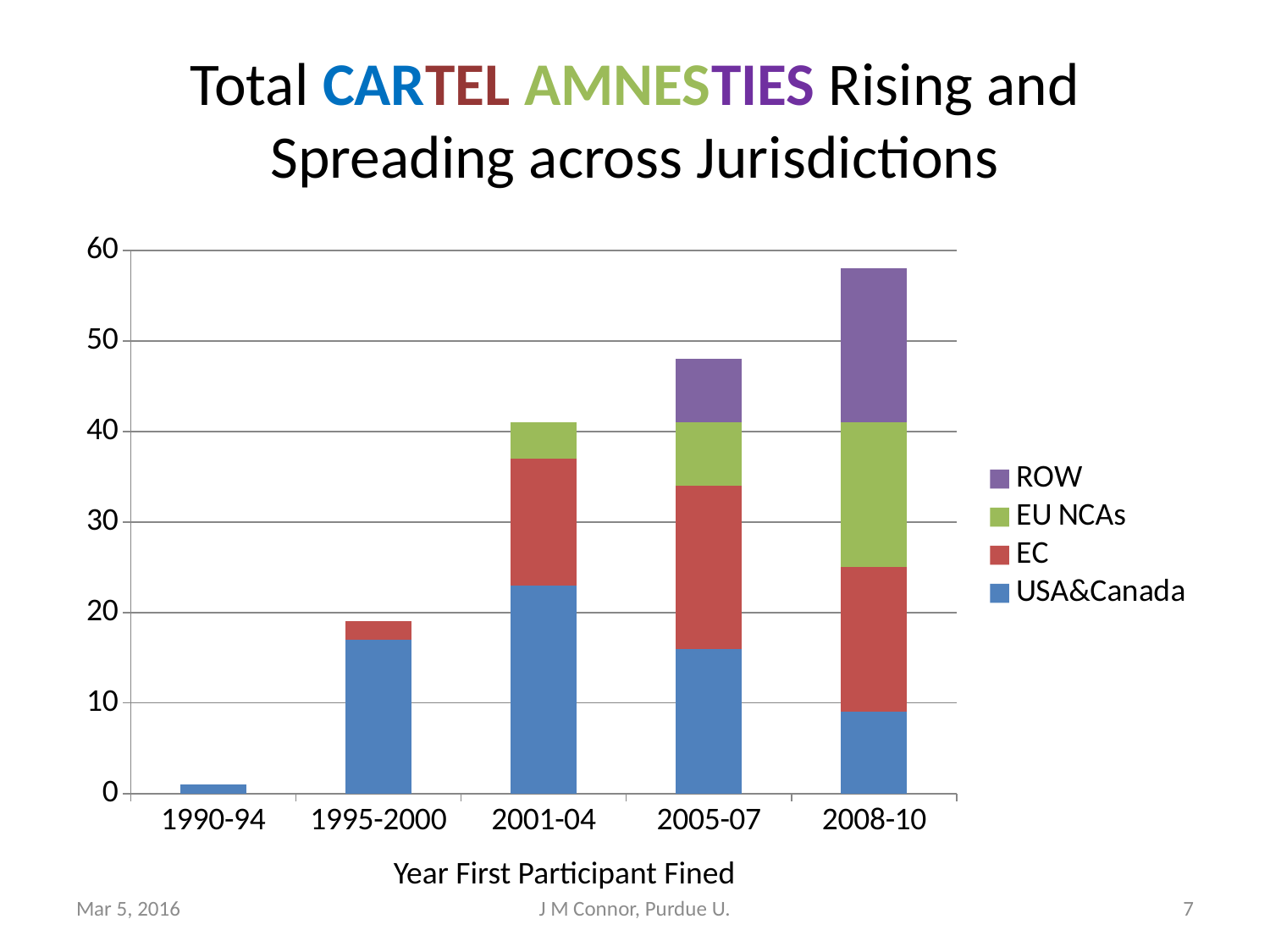
Is the total for 2008-10 greater or less than 50? greater Which is larger, the total for 2005-07 or the total for 2008-10? 2008-10 Which is larger, the USA&Canada value for 2001-04 or for 2008-10? 2001-04 How many year-period categories are shown on the x axis? 5 Which period has the highest total bar? 2008-10 Is the USA&Canada value for 2001-04 greater or less than 20? greater What kind of chart is shown on the slide? Stacked bar chart What is the title of the x axis? Year First Participant Fined Which period has the lowest total bar? 1990-94 Is the total for 2001-04 greater or less than 30? greater Do the total bar heights rise or fall from 1990-94 to 2008-10? Rise How many series does the legend list? 4